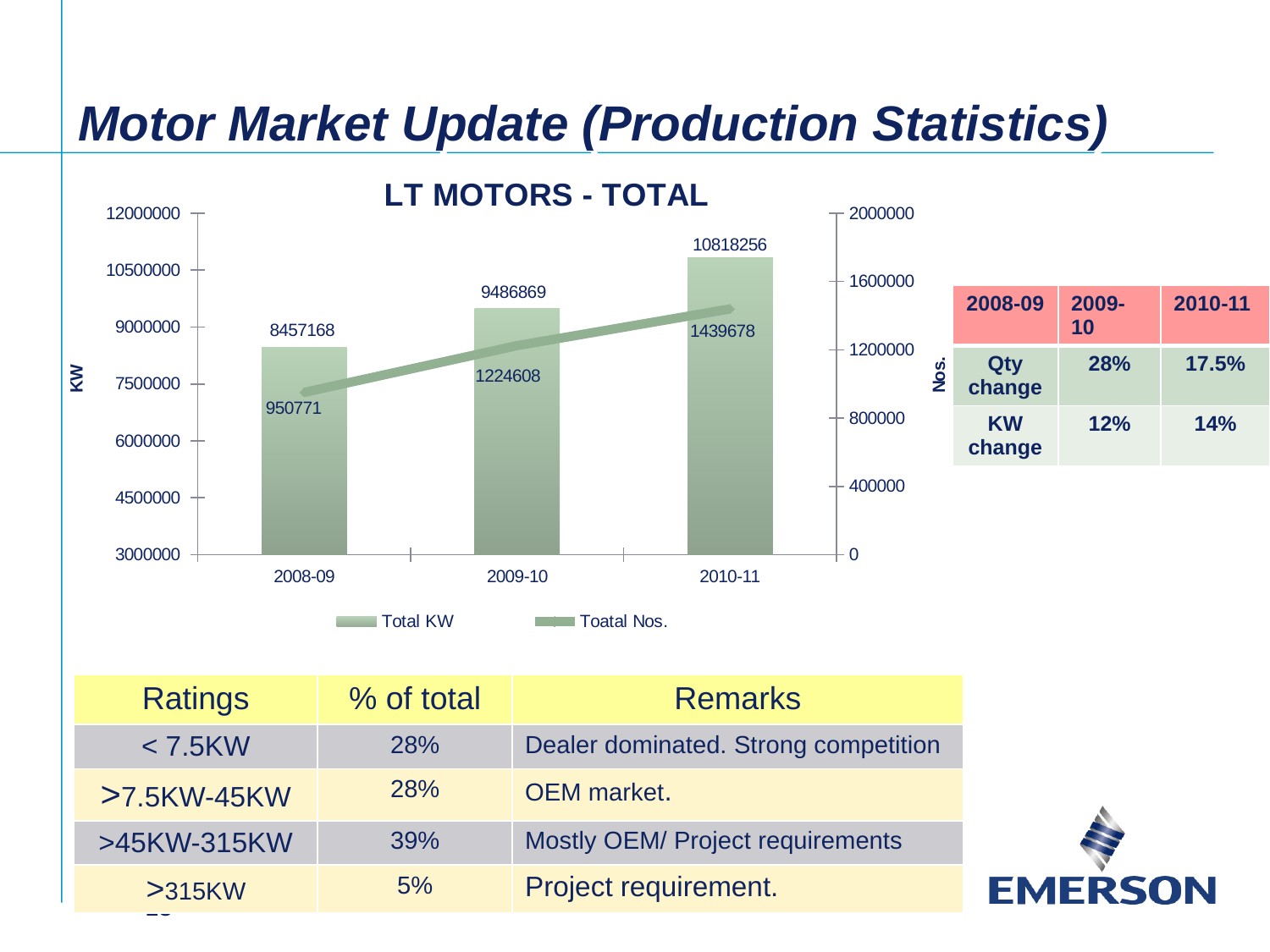
What is the label of the left vertical axis in the LT MOTORS - TOTAL chart? KW Which year has the lowest Toatal Nos. in the LT MOTORS - TOTAL chart? 2008-09 How many series does the legend of the LT MOTORS - TOTAL chart list? 2 What is the Total KW value for 2010-11 in the LT MOTORS - TOTAL chart? 10818256 How many years are shown on the x axis of the LT MOTORS - TOTAL chart? 3 In the LT MOTORS - TOTAL chart, is the Total KW for 2008-09 larger or smaller than for 2009-10? smaller What is the Total KW value for 2009-10 in the LT MOTORS - TOTAL chart? 9486869 What is the Toatal Nos. value for 2008-09 in the LT MOTORS - TOTAL chart? 950771 What is the difference in Toatal Nos. between 2009-10 and 2008-09 in the LT MOTORS - TOTAL chart? 273837 Which year has the highest Total KW in the LT MOTORS - TOTAL chart? 2010-11 What is the difference in Total KW between 2010-11 and 2009-10 in the LT MOTORS - TOTAL chart? 1331387 Do the Total KW values rise or fall from 2008-09 to 2010-11 in the LT MOTORS - TOTAL chart? rise